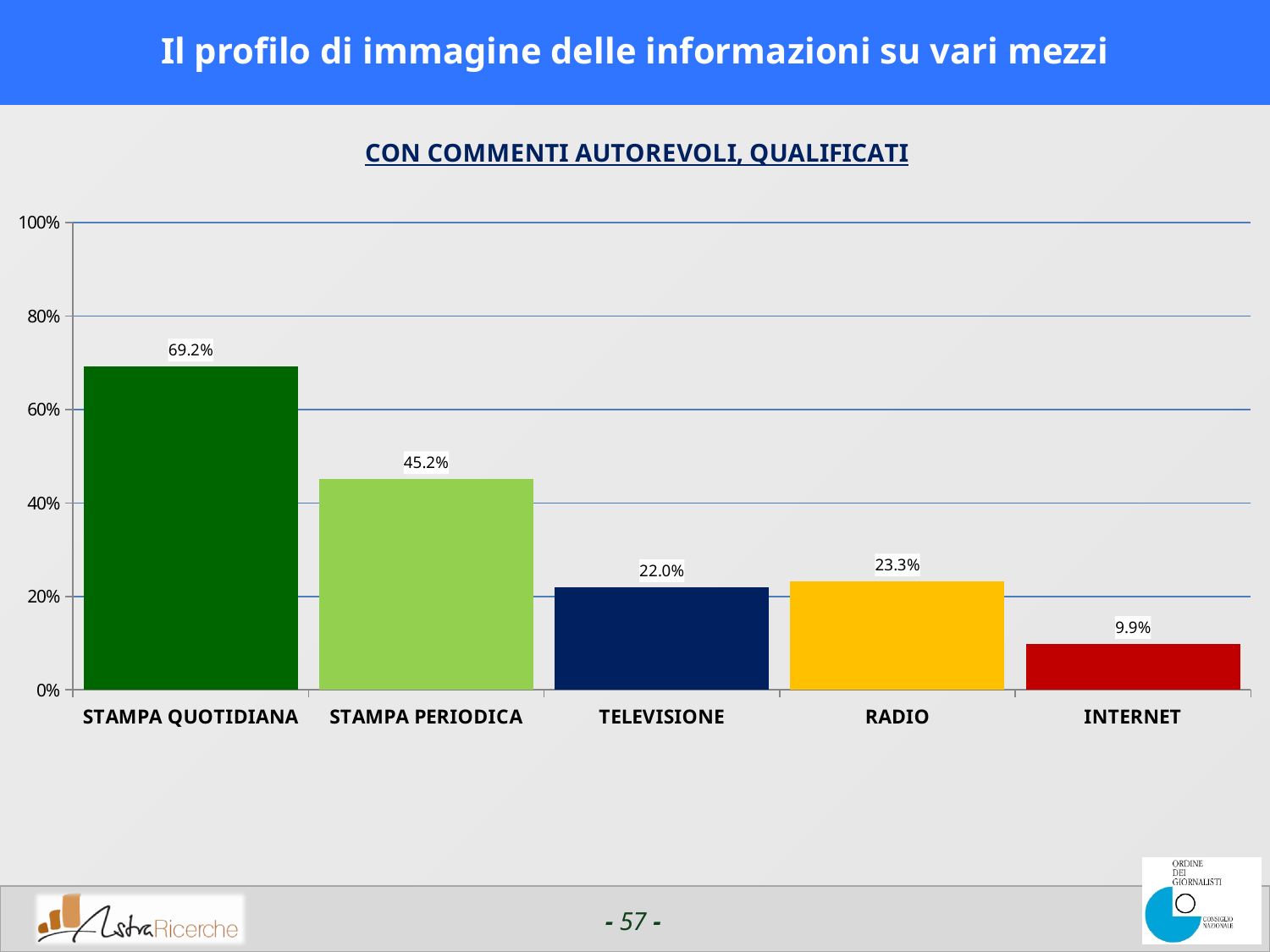
What is the difference between the values for RADIO and TELEVISIONE? 1.3% What kind of chart is shown on the slide? bar chart What is the difference between the values for STAMPA QUOTIDIANA and STAMPA PERIODICA? 24.0% What is the title shown above the chart? CON COMMENTI AUTOREVOLI, QUALIFICATI Which category has the lowest value? INTERNET How many categories are shown on the x axis? 5 What is the value for STAMPA QUOTIDIANA? 69.2% Which category has the highest value? STAMPA QUOTIDIANA What is the value for TELEVISIONE? 22.0% Which is larger, the value for STAMPA PERIODICA or the value for RADIO? STAMPA PERIODICA What is the value for INTERNET? 9.9% Is the value for STAMPA PERIODICA greater or less than 40%? greater